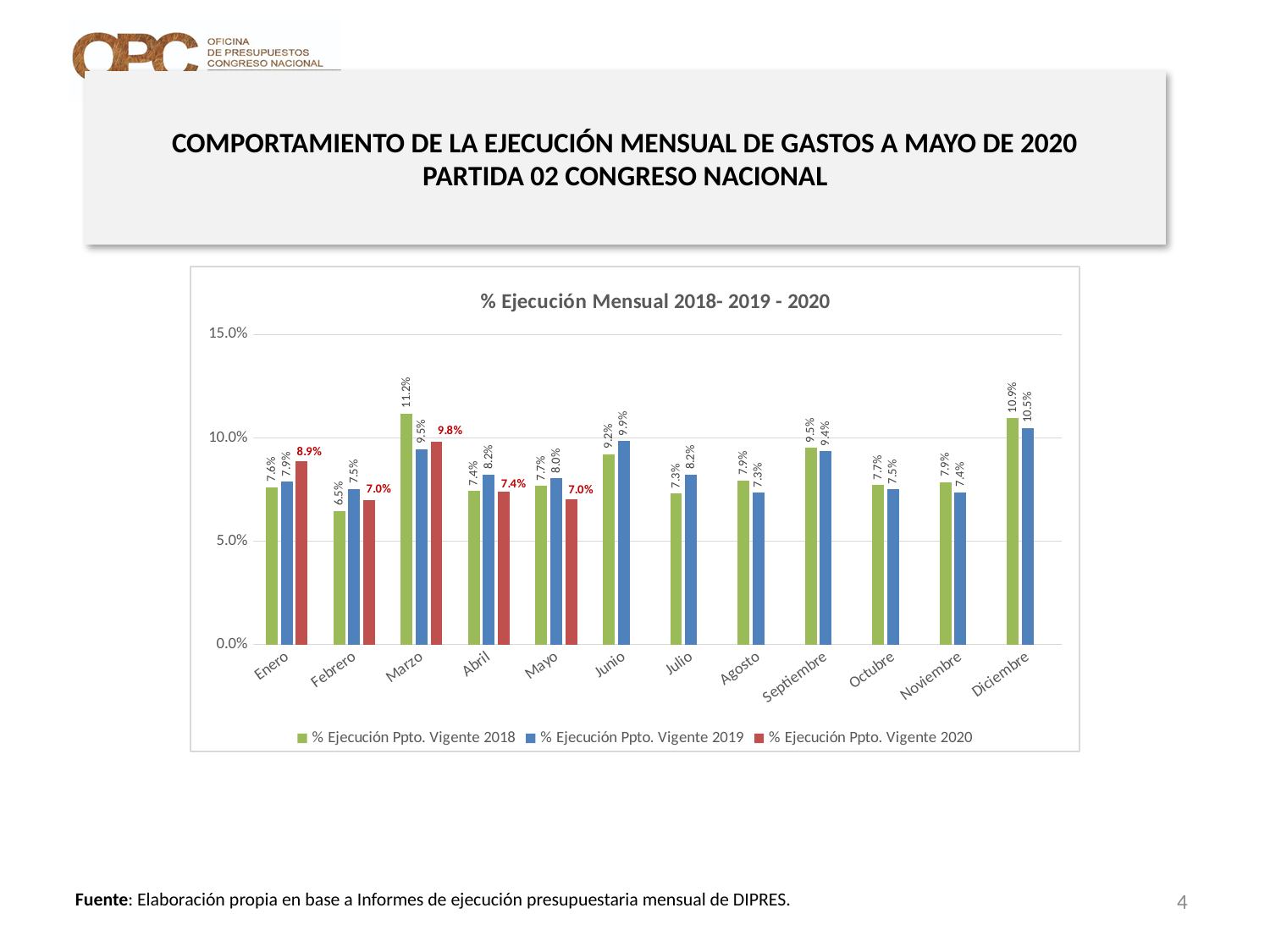
Which month has the highest value for % Ejecución Ppto. Vigente 2018? Marzo How many series does the legend list? 3 What is the difference between the 2018 and 2019 values in Marzo? 1.7% What is the value for % Ejecución Ppto. Vigente 2019 in Diciembre? 10.5% Which month has the lowest value for % Ejecución Ppto. Vigente 2020? Febrero and Mayo (7.0%) Is the value for % Ejecución Ppto. Vigente 2018 in Diciembre greater or less than 10.0%? greater In Mayo, which is larger: the 2019 value or the 2020 value? 2019 (8.0%) What is the value for % Ejecución Ppto. Vigente 2018 in Marzo? 11.2% What is the title of the chart? % Ejecución Mensual 2018- 2019 - 2020 What kind of chart is shown on the slide? Bar chart How many months are shown on the x axis? 12 What is the value for % Ejecución Ppto. Vigente 2020 in Enero? 8.9%